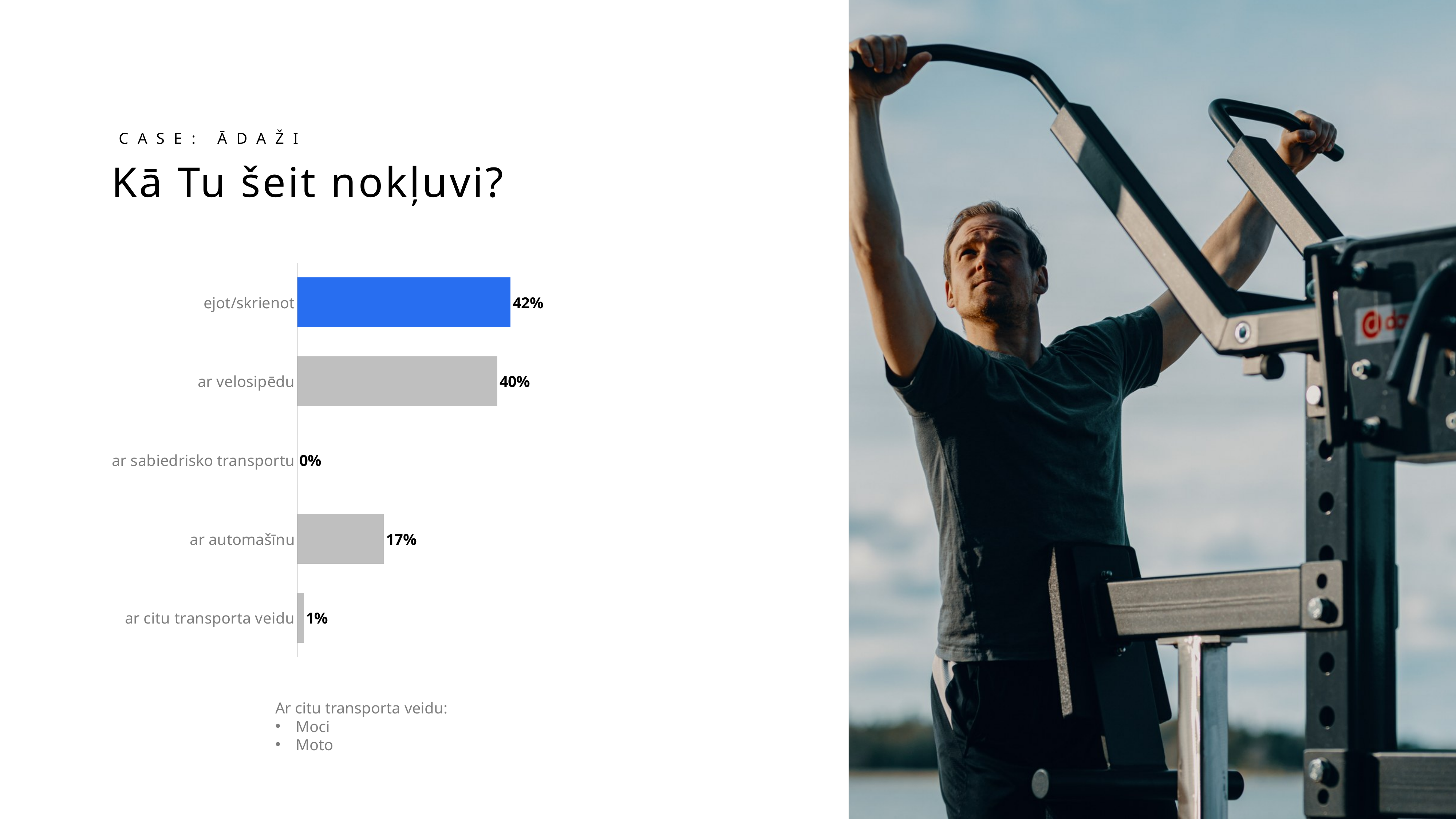
What is the value for ar velosipēdu? 40% What is the value for ar citu transporta veidu? 1% Which category has the lowest value? ar sabiedrisko transportu What percentage of respondents arrived ejot/skrienot? 42% What is the value for ar automašīnu? 17% How many categories does the chart show? 5 What is the difference between the values for ejot/skrienot and ar velosipēdu? 2% What is the value for ar sabiedrisko transportu? 0% What is the difference between the values for ar velosipēdu and ar automašīnu? 23% What kind of chart is shown on the slide? bar chart Which category has the highest value? ejot/skrienot Which is larger, the value for ar automašīnu or the value for ar citu transporta veidu? ar automašīnu